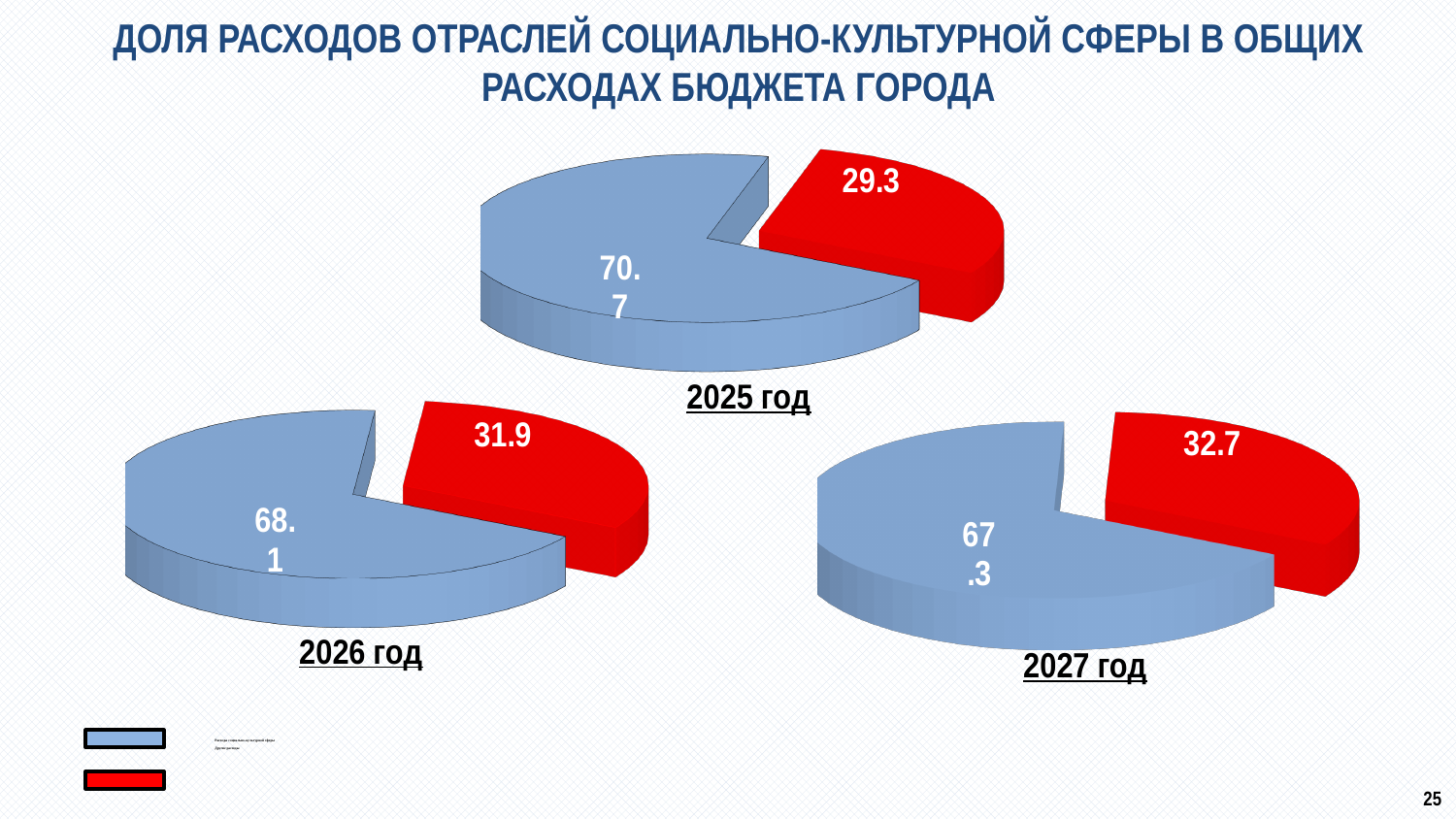
In the 2027 год pie chart, what value is shown on the red slice? 32.7 In the 2026 год pie chart, what value is shown on the red slice? 31.9 In the 2025 год pie chart, what value is shown on the red slice? 29.3 Which year's pie chart has the smallest blue slice value? 2027 год Which year's pie chart has the largest red slice value? 2027 год In the 2026 год pie chart, which slice is larger, the blue one or the red one? The blue one How many slices does the 2026 год pie chart have? 2 In the 2025 год pie chart, what value is shown on the blue slice? 70.7 In the 2025 год pie chart, what is the difference between the blue slice value and the red slice value? 41.4 What kind of chart is used for each year on this slide? Pie chart Across the three pie charts from 2025 год to 2027 год, does the red slice value rise or fall? Rise In the 2027 год pie chart, what value is shown on the blue slice? 67.3